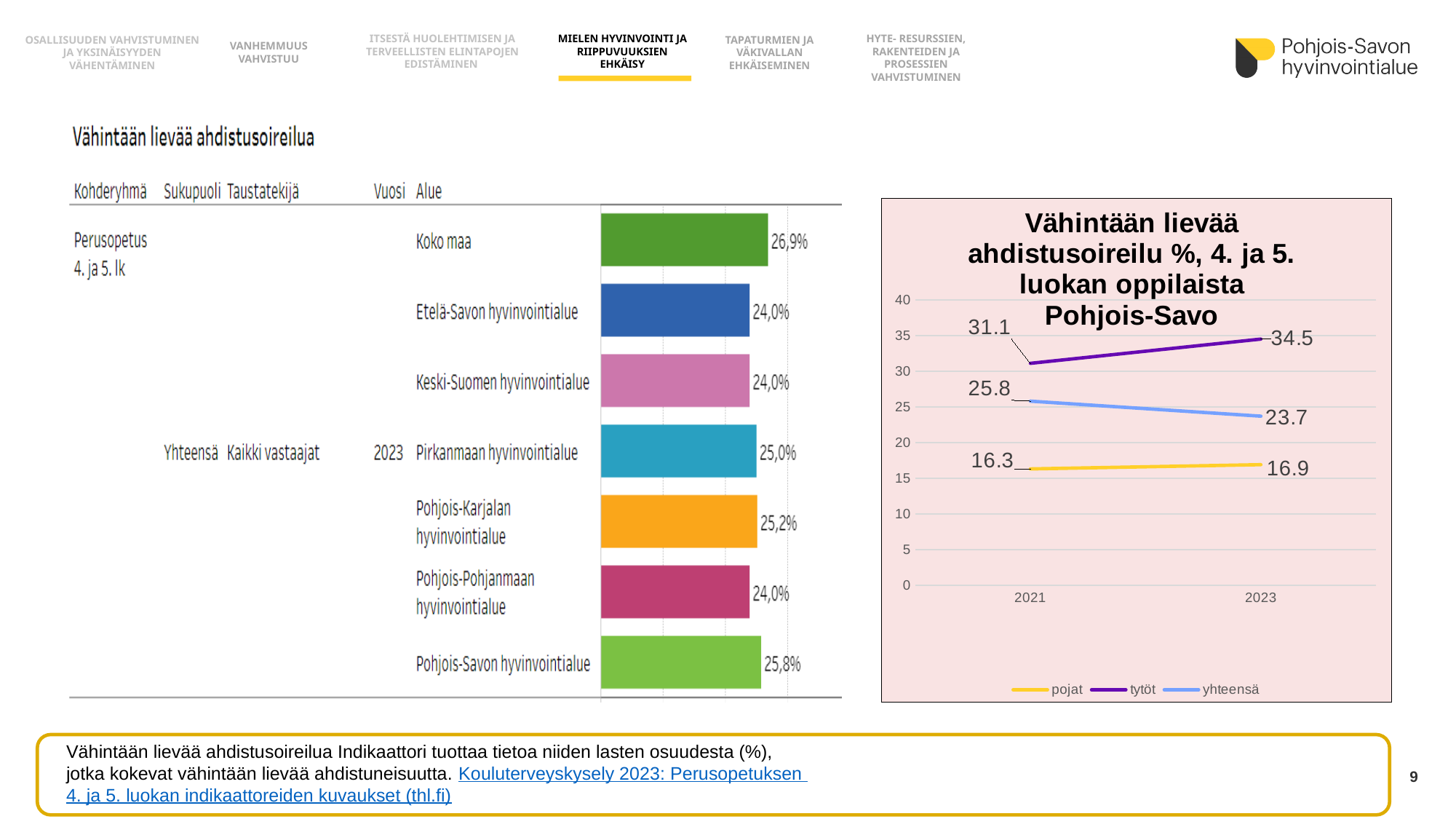
How many series does the legend of the right line chart list? 3 In the right line chart (Pohjois-Savo), does the yhteensä series rise or fall from 2021 to 2023? Fall In the right line chart (Pohjois-Savo), what is the value for tytöt in 2023? 34.5 In the right line chart (Pohjois-Savo), what is the value for pojat in 2021? 16.3 What kind of chart is the left chart? Bar chart In the left bar chart, which area has the highest value? Koko maa In the right line chart (Pohjois-Savo), by how much did the tytöt value change from 2021 to 2023? 3.4 How many areas are shown in the left bar chart? 7 In the left bar chart, which is larger: Pohjois-Karjalan hyvinvointialue or Pirkanmaan hyvinvointialue? Pohjois-Karjalan hyvinvointialue In the left bar chart, what is the difference between Koko maa and Pohjois-Savon hyvinvointialue? 1,1 percentage points In the left bar chart, what is the value for Pohjois-Savon hyvinvointialue? 25,8% In the left bar chart, what is the value for Koko maa? 26,9%